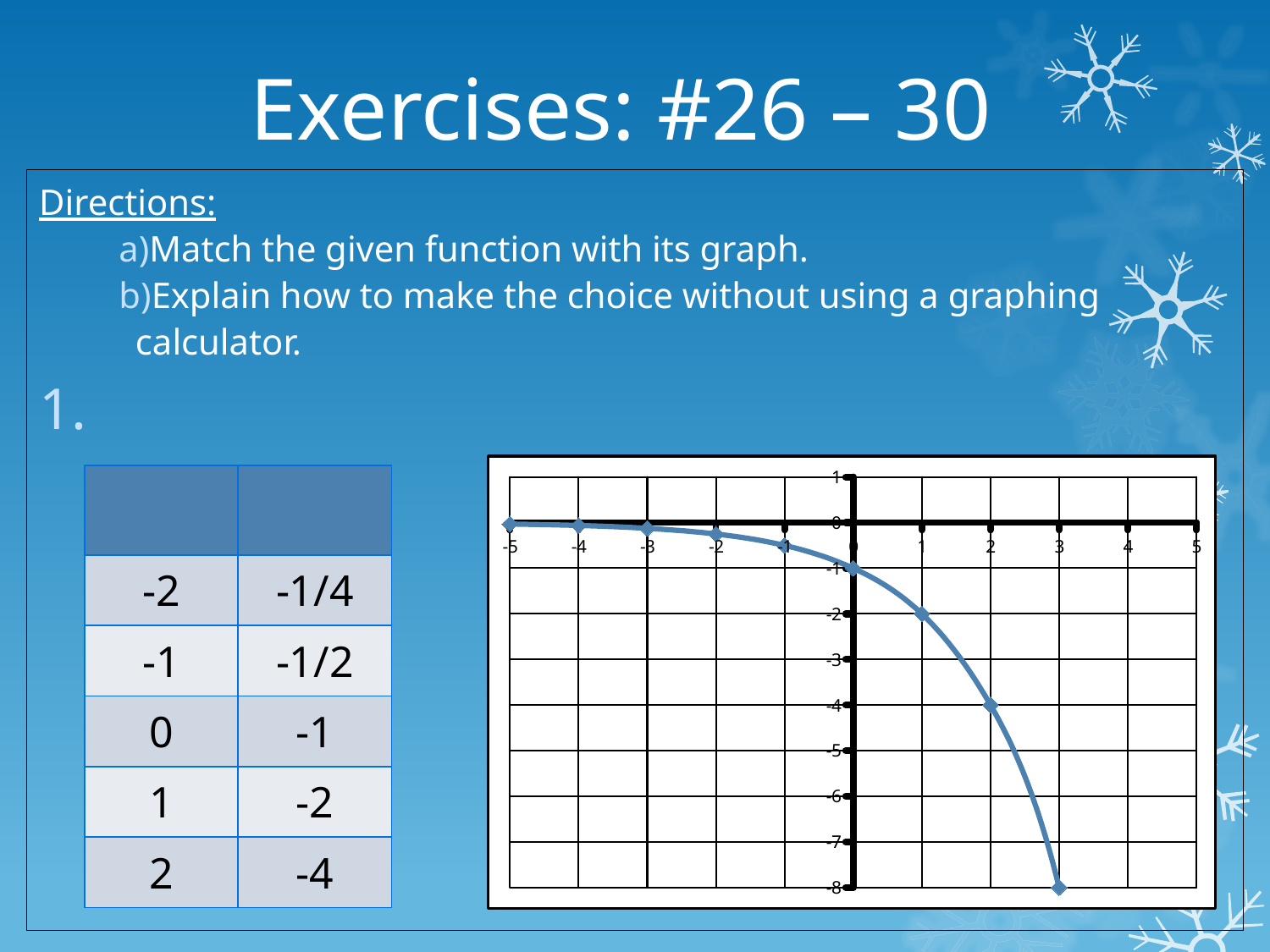
Which plotted point is lower, the one at x = 1 or the one at x = 2? x = 2 Is the plotted value at x = 3 greater or less than -5? less What is the difference between the plotted values at x = 2 and x = 3? 4 At which x-value does the plotted curve reach its lowest point? 3 What is the y-value of the plotted point at x = 1? -2 Is the plotted value at x = -2 greater or less than -1? greater What is the y-value of the plotted point at x = 2? -4 What kind of chart is shown on the slide? line chart What is the lowest value shown on the y-axis of the chart? -8 What is the y-value of the plotted point at x = 3? -8 What is the y-value of the plotted point at x = 0? -1 As x increases from -5 to 3, do the plotted values rise or fall? fall